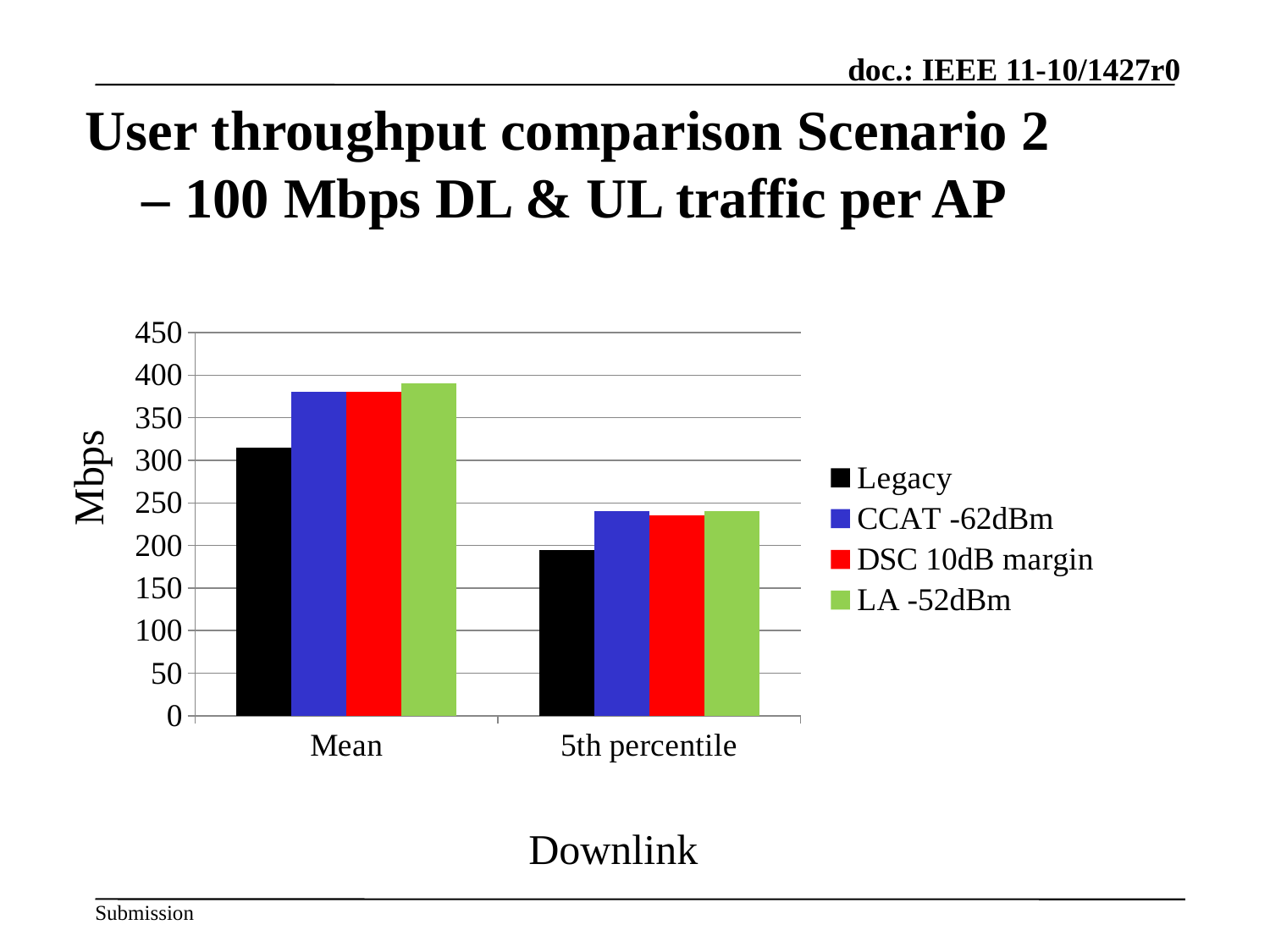
Which series has the lowest value for the 5th percentile category? Legacy Is the CCAT -62dBm value for 5th percentile greater or less than 200? greater How many series does the chart's legend list? 4 For the Mean category, which is larger: the Legacy value or the CCAT -62dBm value? CCAT -62dBm How many categories are shown on the x axis of the chart? 2 Is the Legacy value for Mean greater or less than 350? less Is the LA -52dBm value for Mean greater or less than 350? greater What is the label on the y axis of the chart? Mbps Which series has the lowest value for the Mean category? Legacy What kind of chart is shown on the slide? bar chart Do the values for each series rise or fall from Mean to 5th percentile? fall